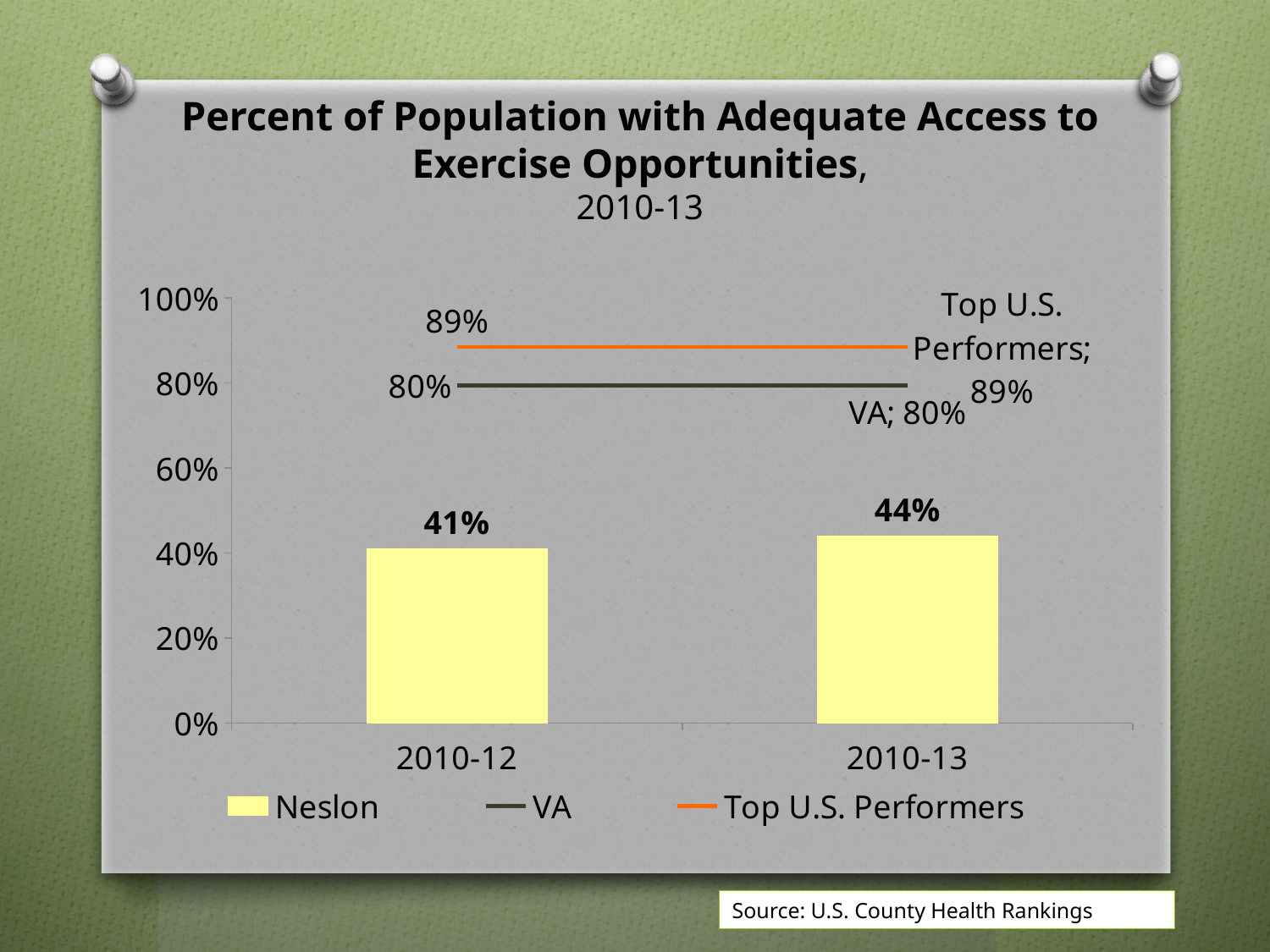
What is the value for VA shown on the chart? 80% What is the value for Top U.S. Performers shown on the chart? 89% What is the value for Neslon in 2010-12? 41% What is the difference between the Top U.S. Performers value and the VA value? 9% What is the difference between the Neslon values for 2010-13 and 2010-12? 3% What is the value for Neslon in 2010-13? 44% What is the source cited for the chart? U.S. County Health Rankings How many series does the legend list? 3 Which is larger, the Neslon value for 2010-12 or for 2010-13? 2010-13 Which series has the highest value on the chart? Top U.S. Performers Which series has the lowest value on the chart? Neslon Do the Neslon values rise or fall from 2010-12 to 2010-13? rise